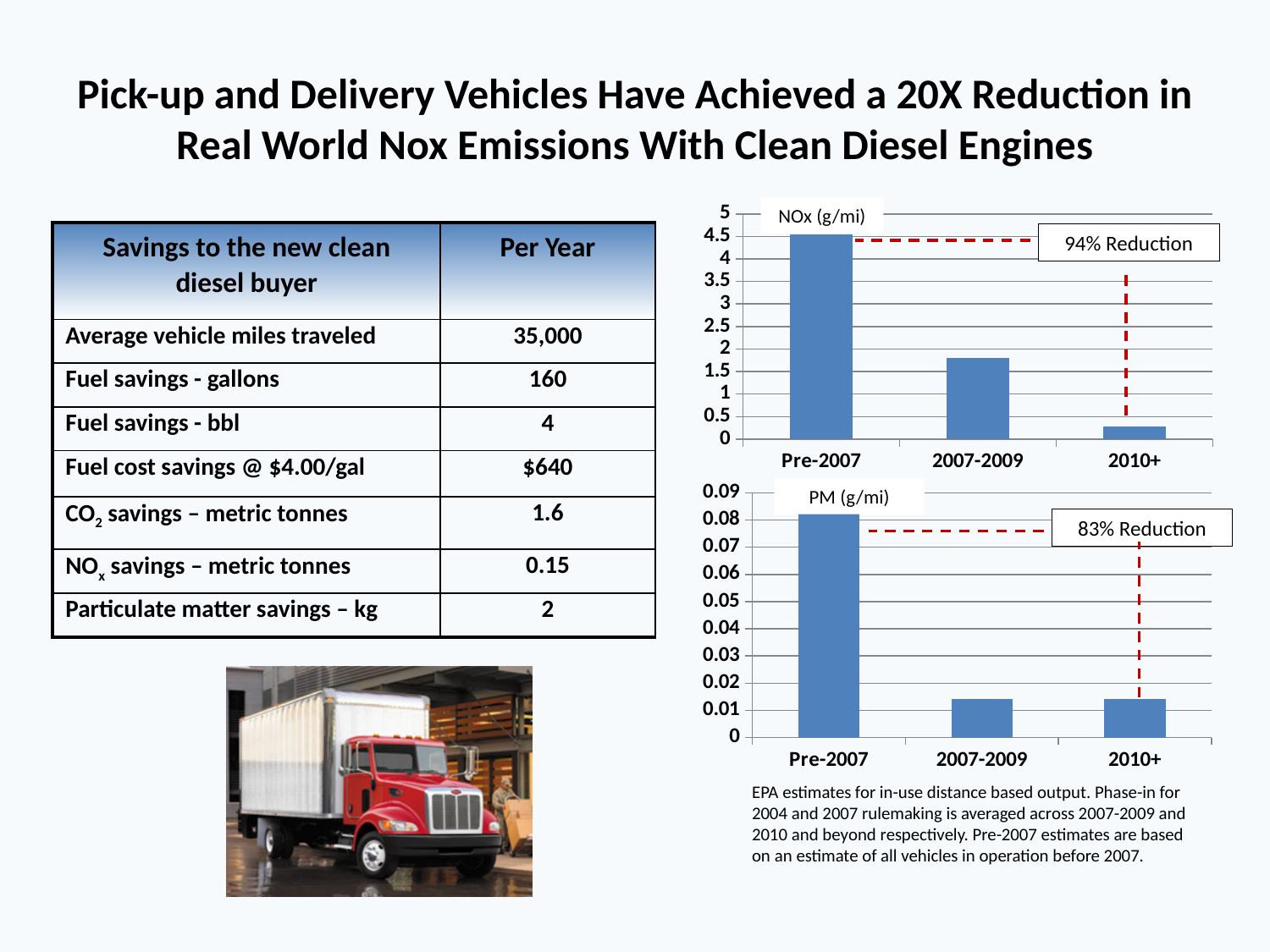
In the NOx (g/mi) chart, which category has the lowest value? 2010+ In the PM (g/mi) chart, is the value for 2007-2009 greater or less than 0.02? less In the PM (g/mi) chart, is the value for Pre-2007 greater or less than 0.08? greater In the NOx (g/mi) chart, which category has the highest value? Pre-2007 In the NOx (g/mi) chart, is the value for 2010+ greater or less than 0.5? less In the PM (g/mi) chart, which category has the highest value? Pre-2007 What percentage reduction is annotated on the PM (g/mi) chart? 83% Reduction How many categories are shown on the x axis of the PM (g/mi) chart? 3 What kind of chart is the NOx (g/mi) chart? bar chart In the NOx (g/mi) chart, do the values rise or fall from Pre-2007 to 2010+? fall In the NOx (g/mi) chart, which is larger, the value for 2007-2009 or the value for 2010+? 2007-2009